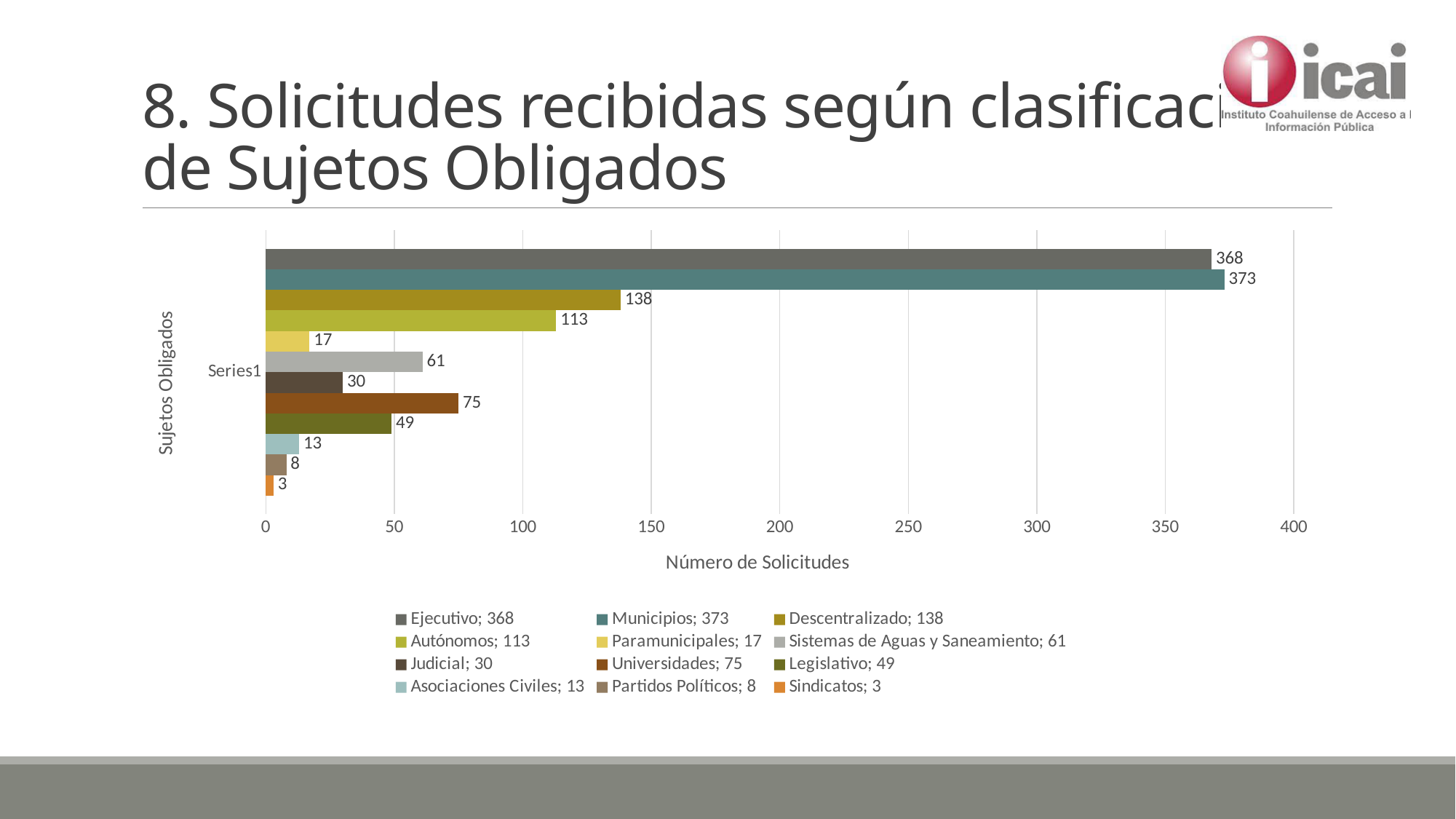
Which category has the highest number of solicitudes? Municipios What is the value for Legislativo? 49 What is the value for Sistemas de Aguas y Saneamiento? 61 How many solicitudes were received for Municipios? 373 What kind of chart is shown on the slide? bar chart Which category has the lowest number of solicitudes? Sindicatos Is the value for Paramunicipales greater or less than 50? less What is the difference between the values for Descentralizado and Autónomos? 25 Which is larger, the value for Universidades or the value for Judicial? Universidades How many entries does the legend list? 12 What is the title of the horizontal axis? Número de Solicitudes What is the difference between the values for Municipios and Ejecutivo? 5